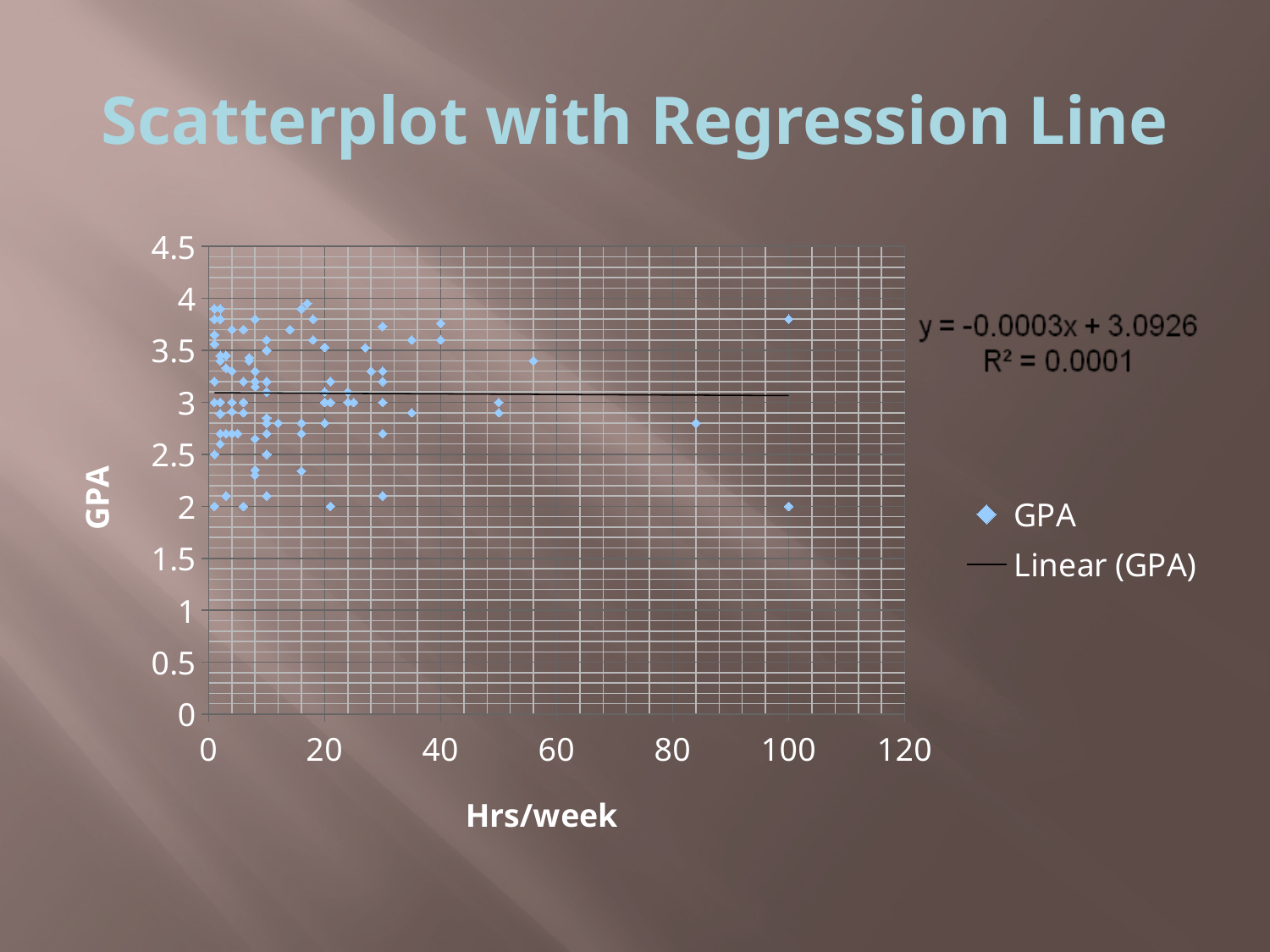
Is the GPA of the upper point at 100 Hrs/week greater or less than 3.5? greater Is the GPA of the lower point at 100 Hrs/week greater or less than 2.5? less What is the regression equation printed on the chart? y = -0.0003x + 3.0926 What is the highest value shown on the x axis? 120 What R² value is printed on the chart? 0.0001 Does the regression line rise or fall as Hrs/week increases? fall What is the highest value shown on the y axis? 4.5 What kind of chart is shown on the slide? scatter plot Is the GPA of the point near 84 Hrs/week greater or less than 3? less How many series does the legend list? 2 Which of the two points at 100 Hrs/week has the higher GPA, the upper one near 3.8 or the lower one near 2? the upper one near 3.8